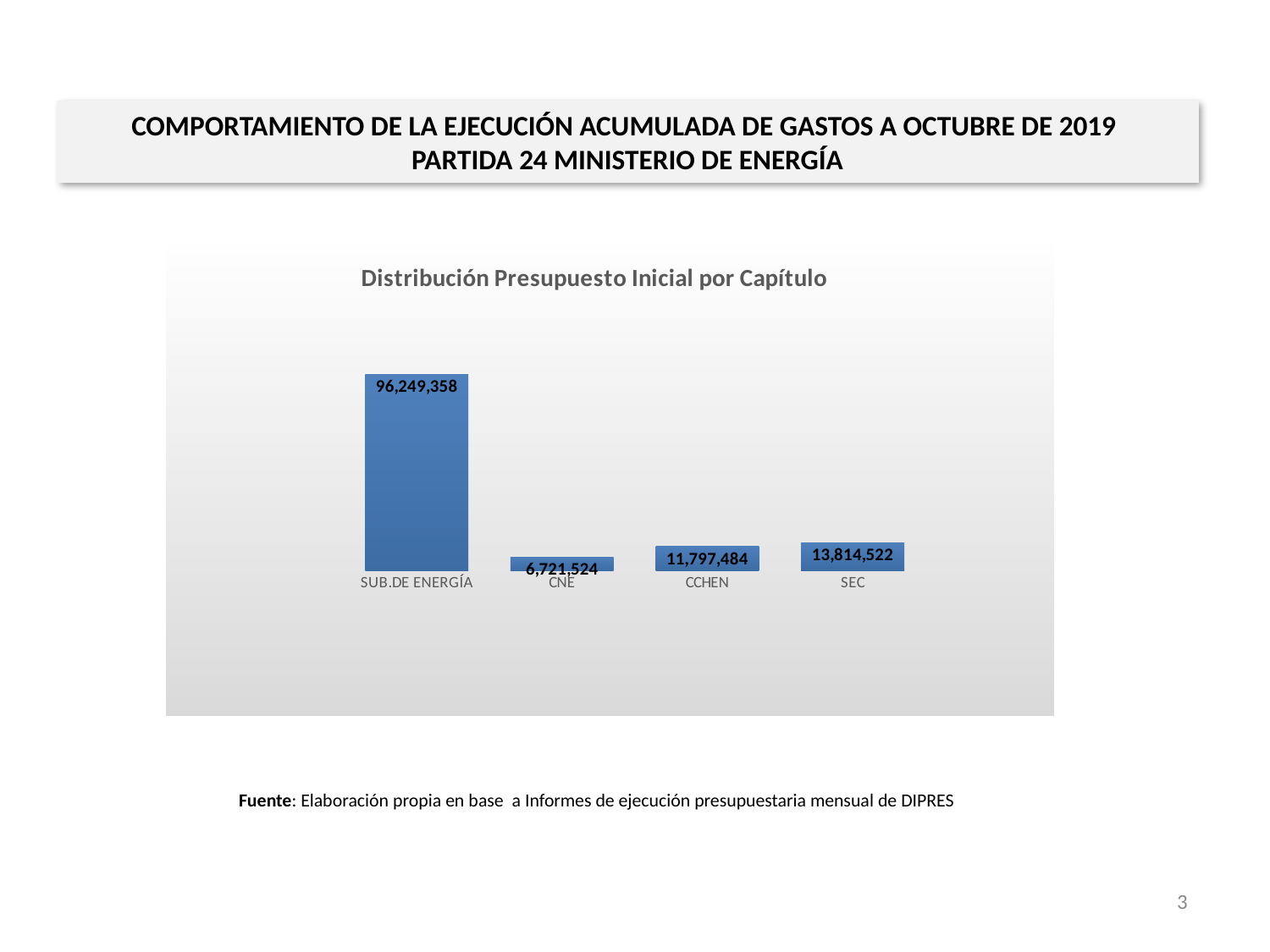
What is the value for CNE? 6,721,524 What is the value for CCHEN? 11,797,484 What is the value for SEC? 13,814,522 What is the difference between the values for SUB.DE ENERGÍA and CNE? 89,527,834 How many categories are shown in the chart? 4 What is the title of the chart? Distribución Presupuesto Inicial por Capítulo Which is larger, the value for CCHEN or the value for SEC? SEC What is the value for SUB.DE ENERGÍA? 96,249,358 What kind of chart is shown on the slide? Bar chart Which category has the highest value? SUB.DE ENERGÍA What is the difference between the values for SEC and CCHEN? 2,017,038 Which category has the lowest value? CNE